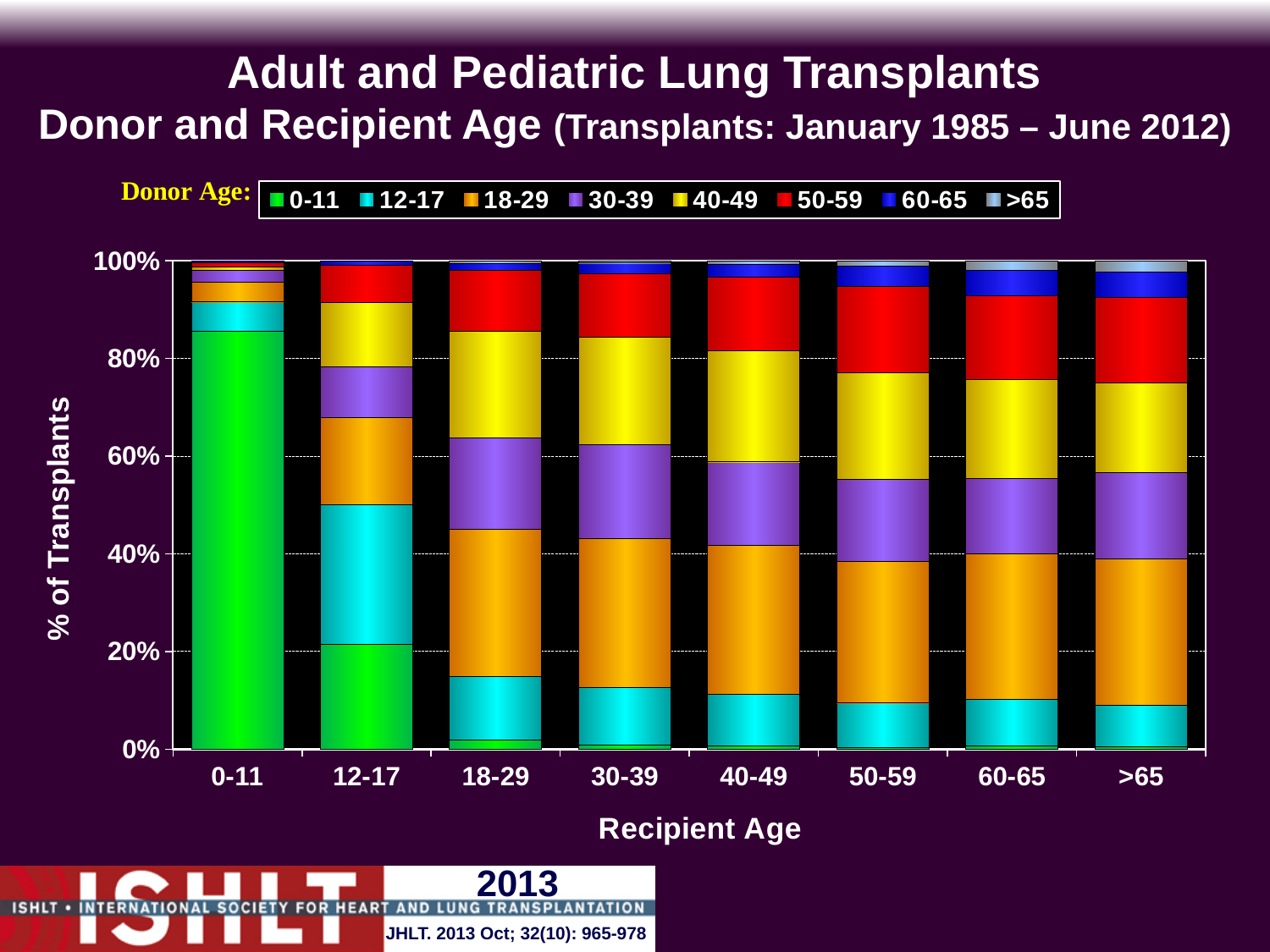
What is the label of the x axis? Recipient Age What is the label of the y axis? % of Transplants How many donor age series does the legend list? 8 Which recipient age group has the largest share of transplants from donors aged 0-11? 0-11 Is the share of transplants from donors aged 0-11 for recipients aged 0-11 greater or less than 80%? greater Which recipient age group has a larger share of transplants from donors aged 12-17: 12-17 or 50-59? 12-17 What does each stacked bar total? 100% How many recipient age categories are shown on the x axis? 8 Is the share of transplants from donors aged 50-59 for recipients aged 0-11 greater or less than 20%? less Which recipient age group has the largest share of transplants from donors aged 12-17? 12-17 What kind of chart is shown on the slide? stacked bar chart Which recipient age group has the largest share of transplants from donors aged >65? >65